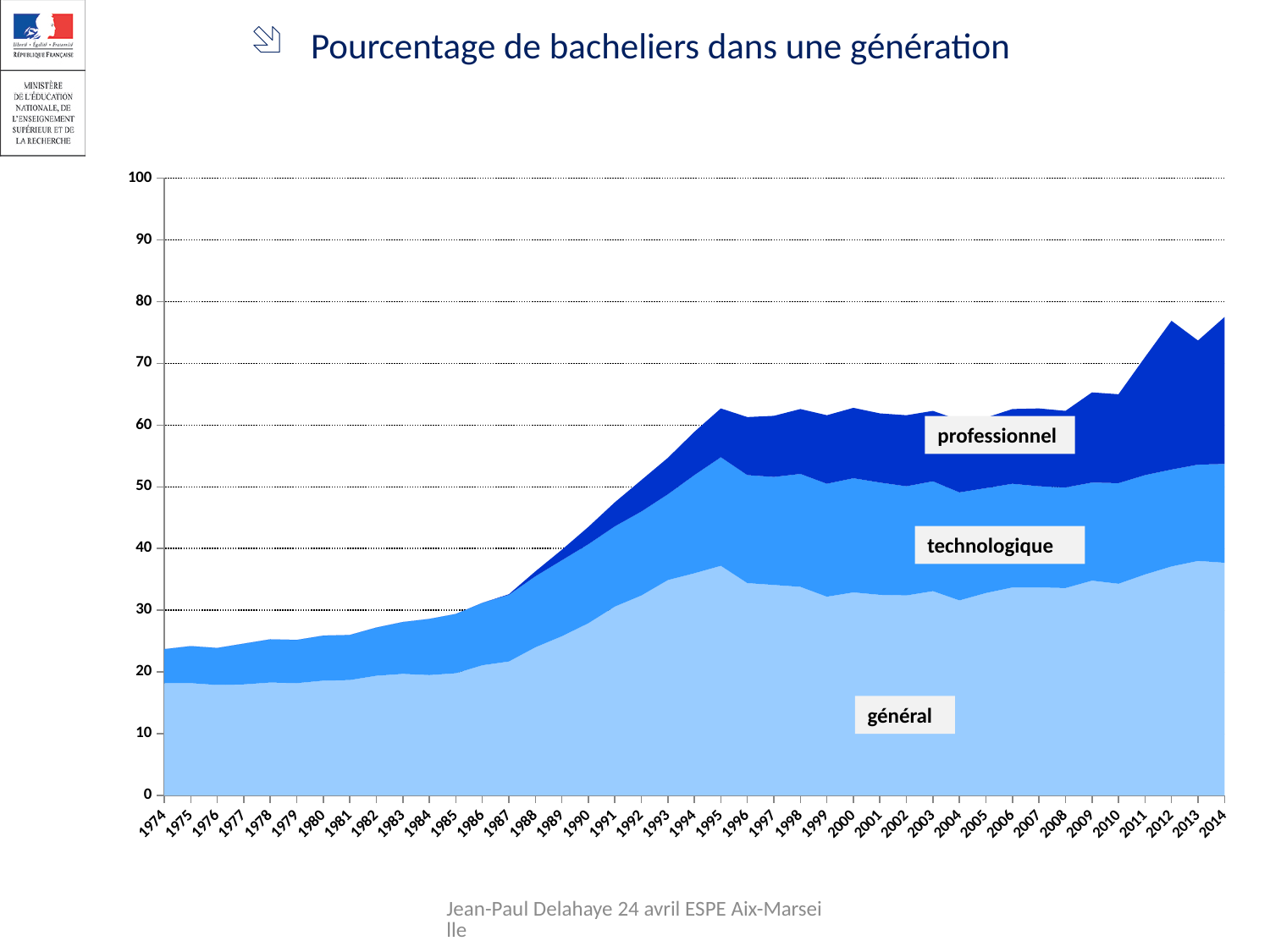
What is the title of the chart? Pourcentage de bacheliers dans une génération Is the total value for 1995 greater or less than 60? greater Is the total value for 2014 greater or less than 70? greater Is the value for général in 1974 greater or less than 20? less Does the total percentage of bacheliers rise or fall from 1974 to 2014? rise Is the total value higher in 2012 or in 2013? 2012 How many years are shown on the x axis? 41 Which series is plotted at the bottom of the stack? général How many series are shown in the chart? 3 What kind of chart is shown on the slide? stacked area chart Which series has the largest value in 2014? général